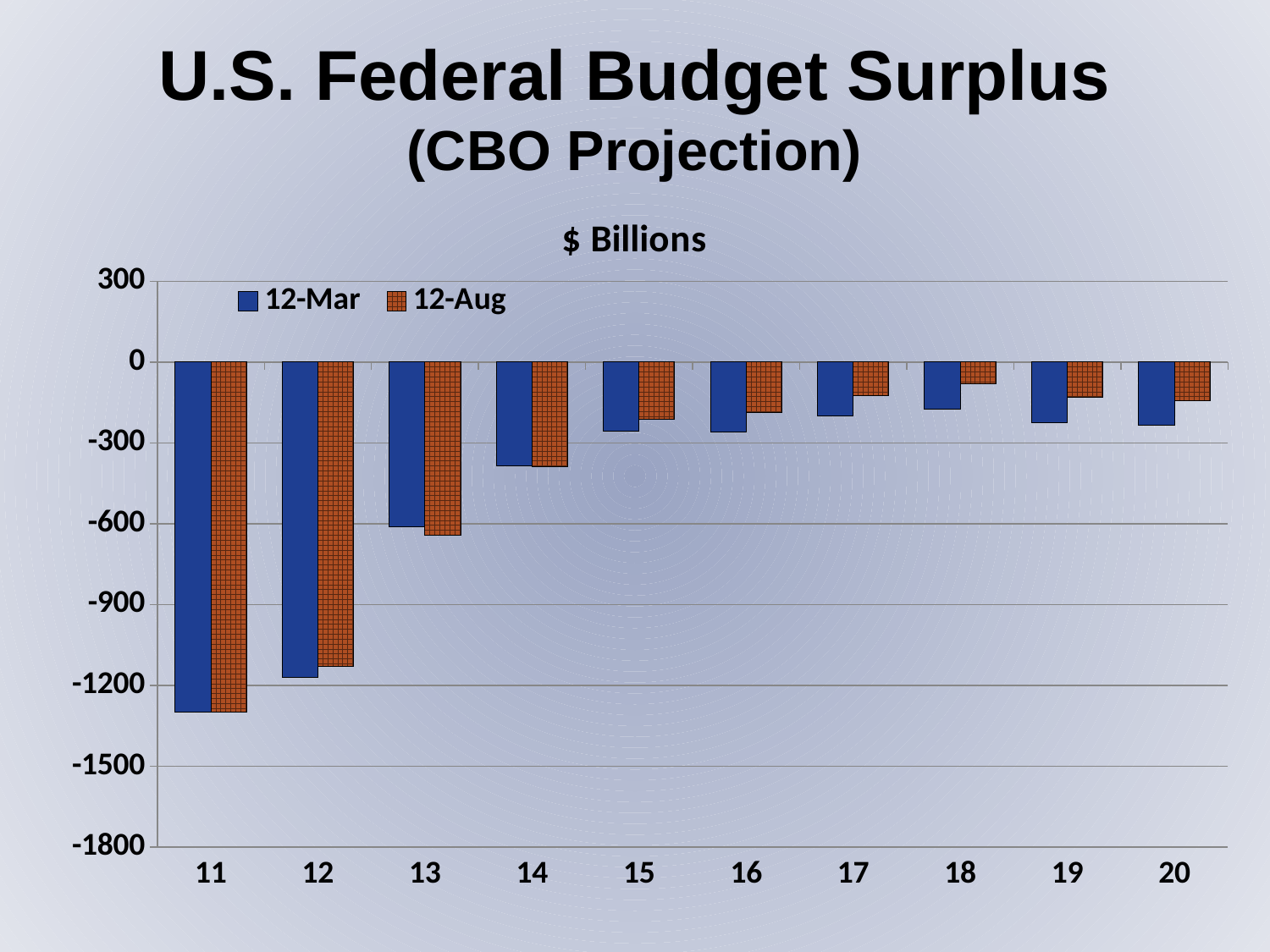
How many series does the legend list? 2 How many years are shown on the x axis? 10 What unit is given in the chart's subtitle above the plot? $ Billions Which year has the highest (least negative) value for the 12-Aug series? 18 What are the two series named in the legend? 12-Mar and 12-Aug What kind of chart is shown on the slide? bar chart Is the 12-Aug value for year 14 greater or less than -300? less Is the 12-Mar value for year 15 greater or less than -300? greater For year 16, which series has the larger (less negative) value, 12-Mar or 12-Aug? 12-Aug Is the 12-Mar value for year 11 greater or less than -1200? less Do the 12-Mar values generally rise or fall from year 11 to year 20? rise Which year has the lowest (most negative) value for the 12-Mar series? 11